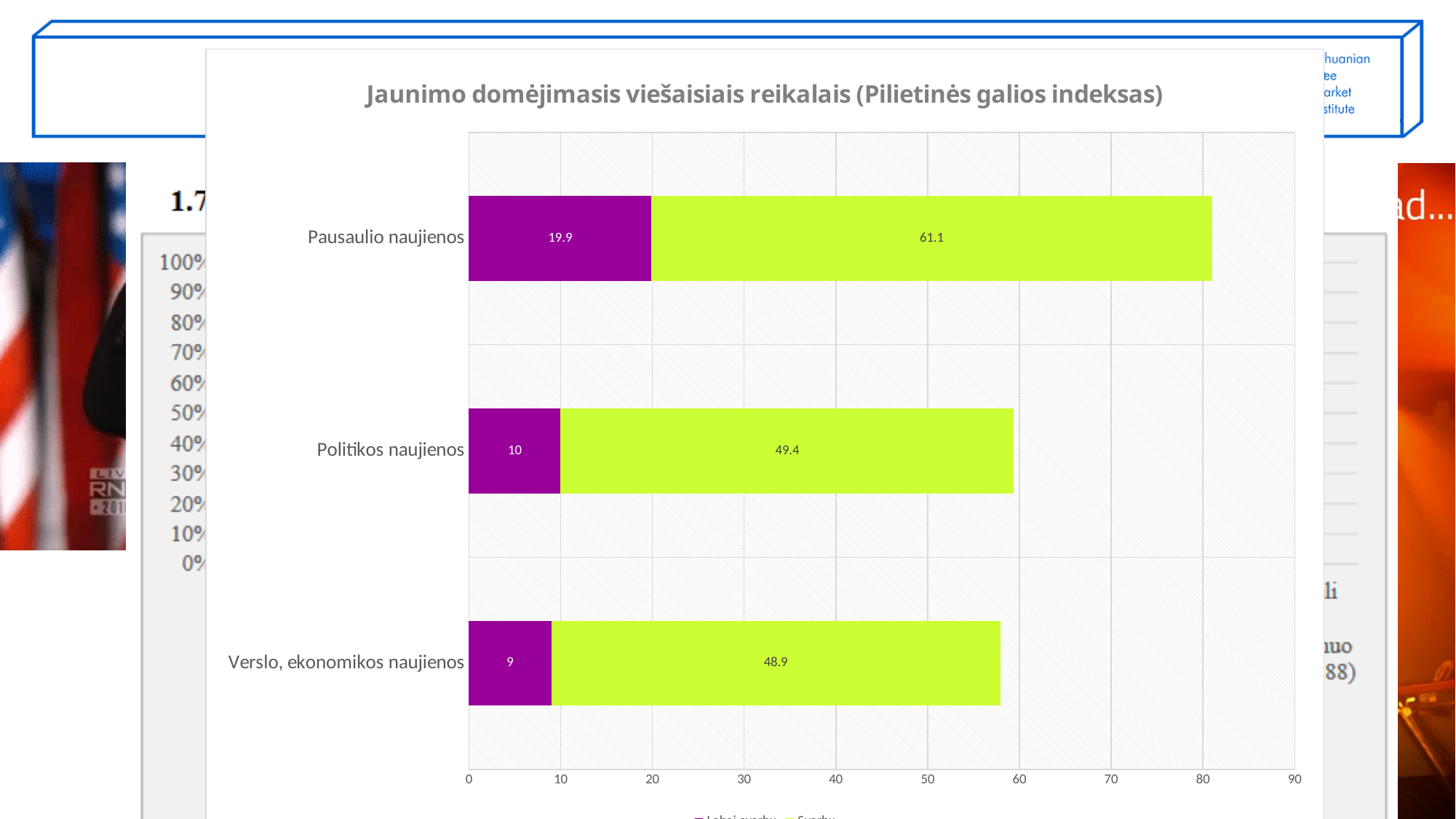
Which category has the smallest purple segment? Verslo, ekonomikos naujienos How many categories are plotted in the chart? 3 What is the value of the purple segment for Pausaulio naujienos? 19.9 Which category has the largest green segment? Pausaulio naujienos Which is larger: the purple segment for Politikos naujienos or the purple segment for Pausaulio naujienos? Pausaulio naujienos What is the value of the green segment for Verslo, ekonomikos naujienos? 48.9 What is the value of the green segment for Politikos naujienos? 49.4 What is the difference between the green segment values for Pausaulio naujienos and Politikos naujienos? 11.7 What is the total of the stacked bar for Pausaulio naujienos? 81 What is the value of the purple segment for Verslo, ekonomikos naujienos? 9 What type of chart is shown on the slide? bar chart What is the title of the chart? Jaunimo domėjimasis viešaisiais reikalais (Pilietinės galios indeksas)